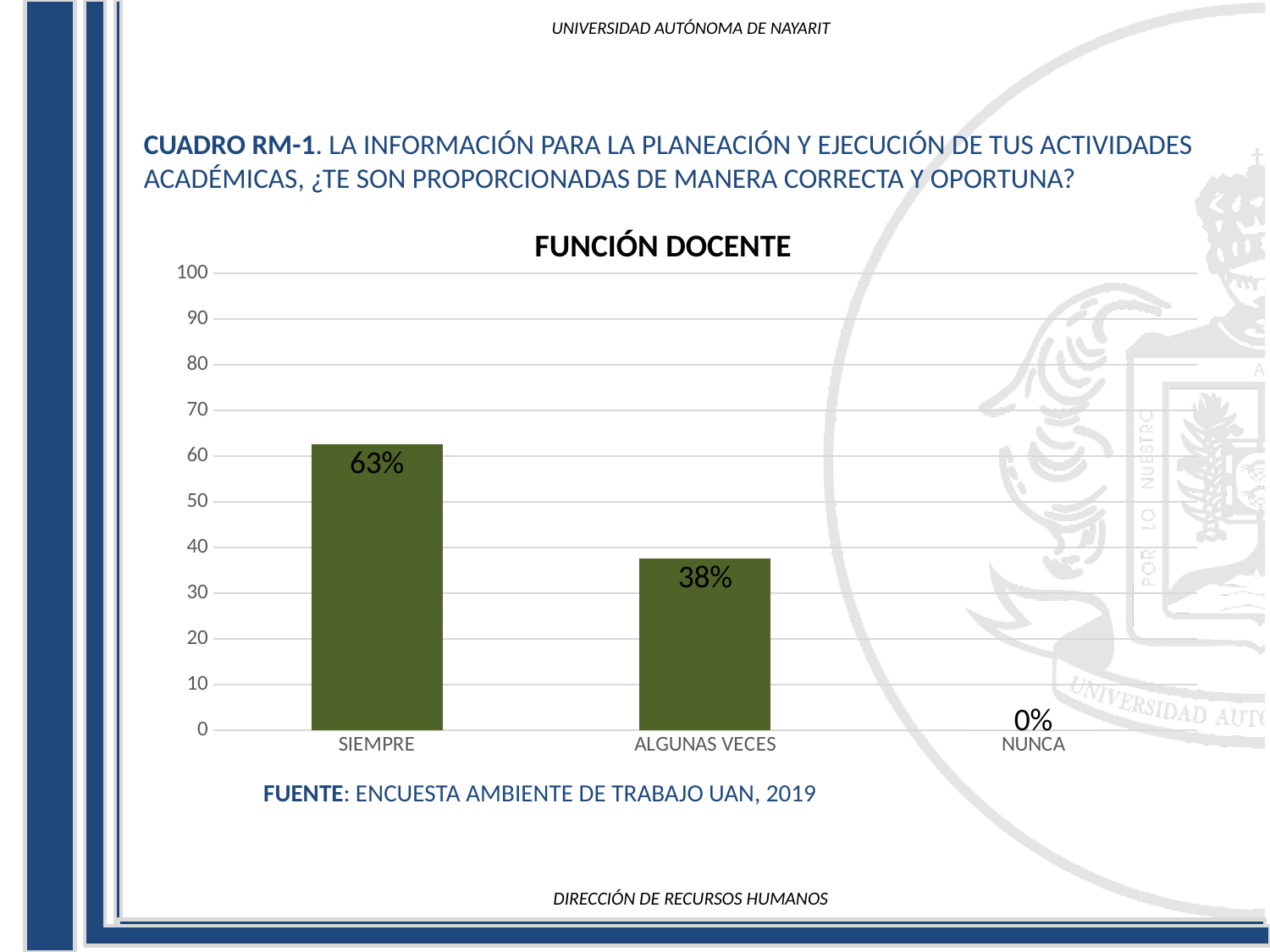
Which category has the lowest value? NUNCA What is the value for NUNCA? 0% How many categories are shown on the x axis? 3 Is the value for SIEMPRE greater or less than 50? greater What kind of chart is shown? bar chart Is the value for ALGUNAS VECES greater or less than 50? less Which category has the highest value? SIEMPRE What is the value for SIEMPRE? 63% What is the title of the chart? FUNCIÓN DOCENTE What is the value for ALGUNAS VECES? 38% What is the difference between the values for SIEMPRE and ALGUNAS VECES? 25% Which is larger, the value for SIEMPRE or the value for ALGUNAS VECES? SIEMPRE